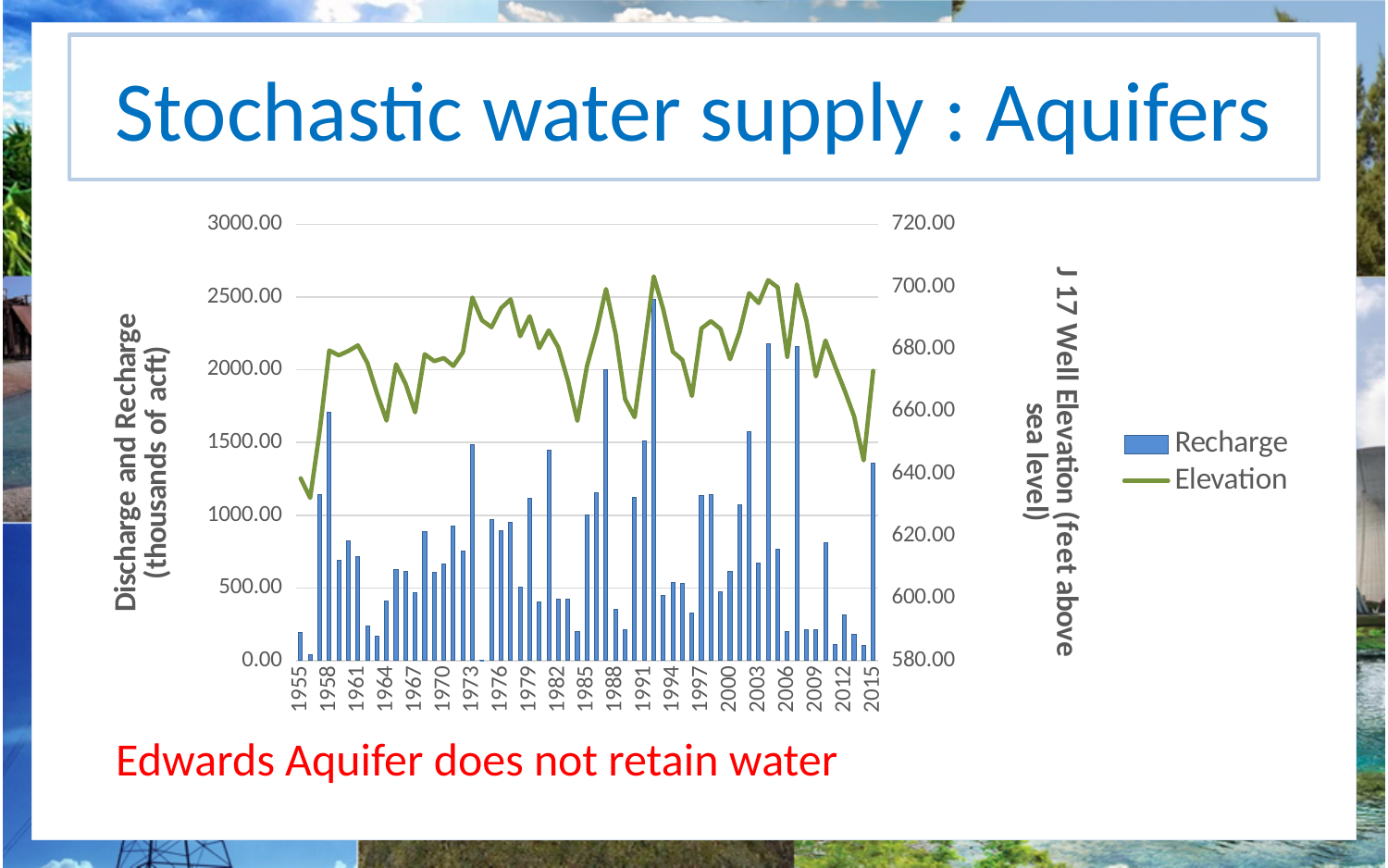
What are the two series named in the chart legend? Recharge and Elevation Is the Elevation value for 1955 greater or less than 660.00? less Is the Recharge value for 1955 greater or less than 500.00? less Is the Elevation value for 2015 greater or less than 660.00? greater Which series is drawn as bars, Recharge or Elevation? Recharge What is the highest value shown on the left vertical axis? 3000.00 How many series does the chart legend list? 2 What kind of chart is shown on the slide? A combined bar and line chart Does the Elevation line rise or fall between 1955 and 1958? rise